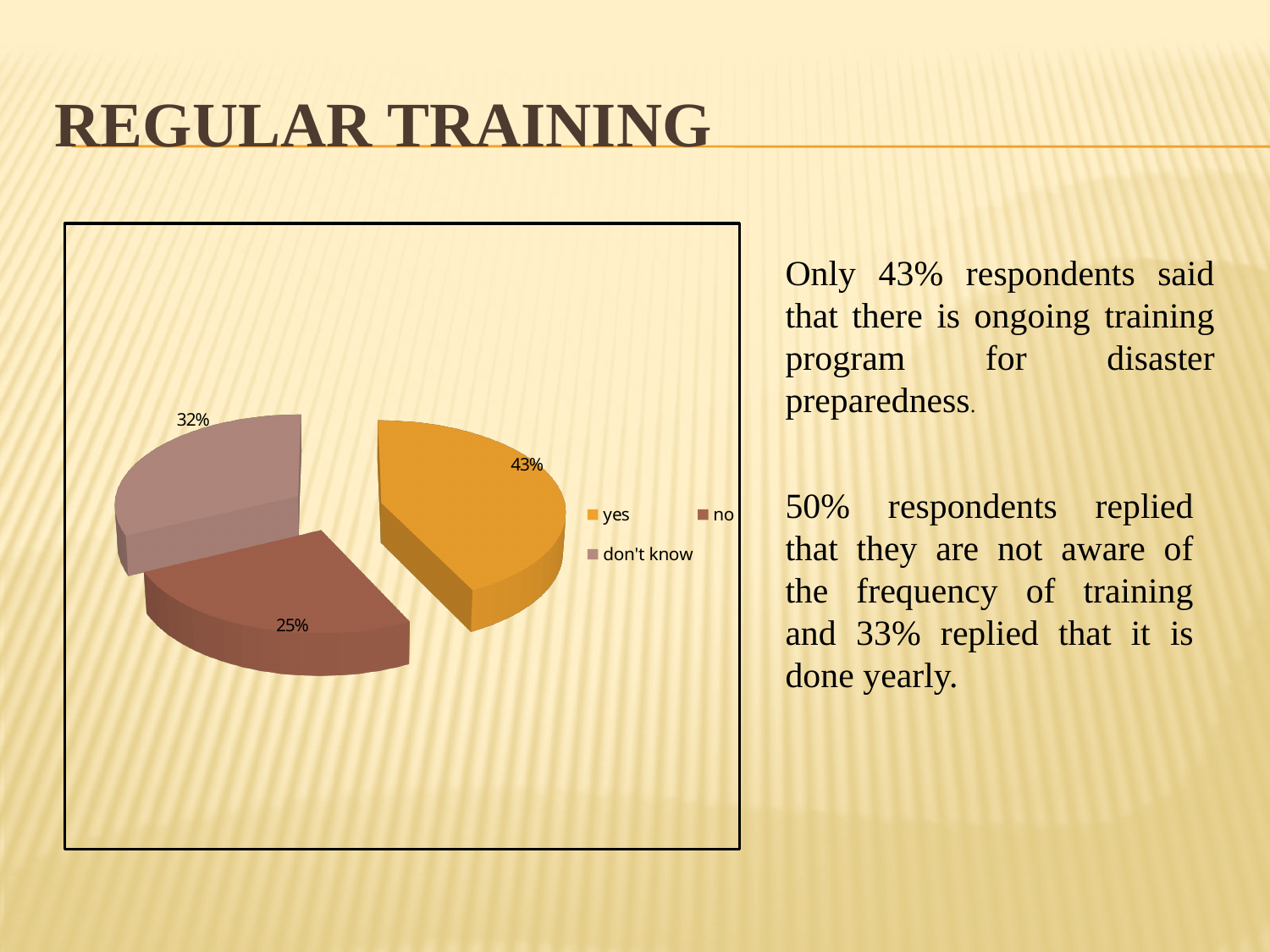
Which response has the smallest share of the pie? no Which response has the largest share of the pie? yes Which is larger, the "don't know" share or the "no" share? don't know What colour is the "yes" slice? orange How many slices does the pie chart have? 3 What percentage of respondents answered "no"? 25% How many entries does the legend list? 3 How many percentage points larger is the "yes" share than the "no" share? 18 What percentage of respondents answered "don't know"? 32% What kind of chart is shown on the slide? pie chart How many percentage points larger is the "don't know" share than the "no" share? 7 What percentage of respondents answered "yes"? 43%